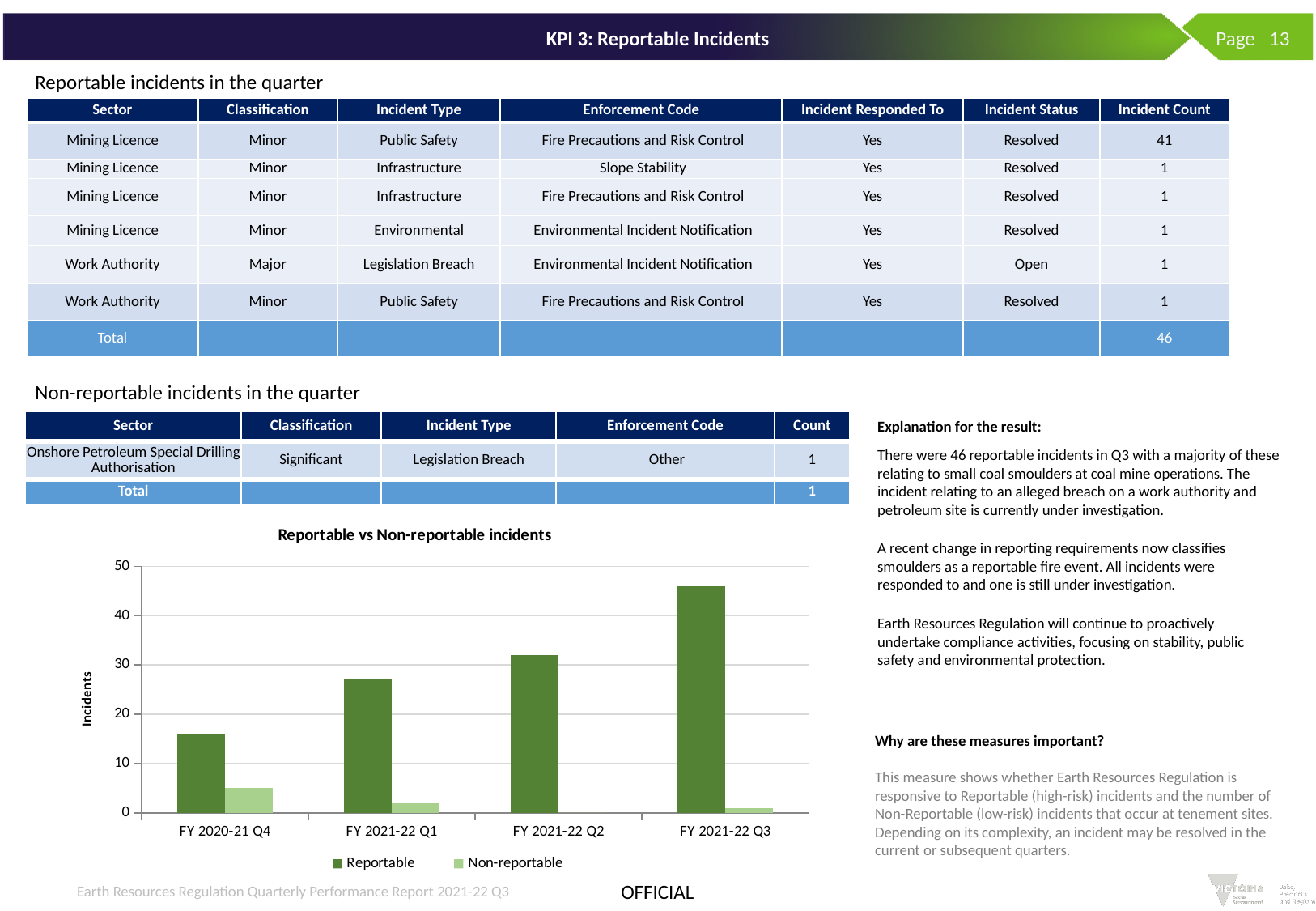
Is the value for Reportable incidents in FY 2021-22 Q3 greater or less than 40? greater Which quarter has the highest number of Reportable incidents in the chart? FY 2021-22 Q3 What type of chart is shown on the slide? Bar chart Is the value for Reportable incidents in FY 2020-21 Q4 greater or less than 20? less Which quarter has the highest number of Non-reportable incidents in the chart? FY 2020-21 Q4 Do Reportable incidents rise or fall across the quarters shown in the chart? Rise Which quarter has the lowest number of Reportable incidents in the chart? FY 2020-21 Q4 Is the value for Reportable incidents in FY 2021-22 Q1 greater or less than 20? greater How many series does the chart legend list? 2 How many quarters are shown on the x axis of the chart? 4 In FY 2021-22 Q3, which is larger in the chart: Reportable or Non-reportable incidents? Reportable What is the title of the chart on the slide? Reportable vs Non-reportable incidents